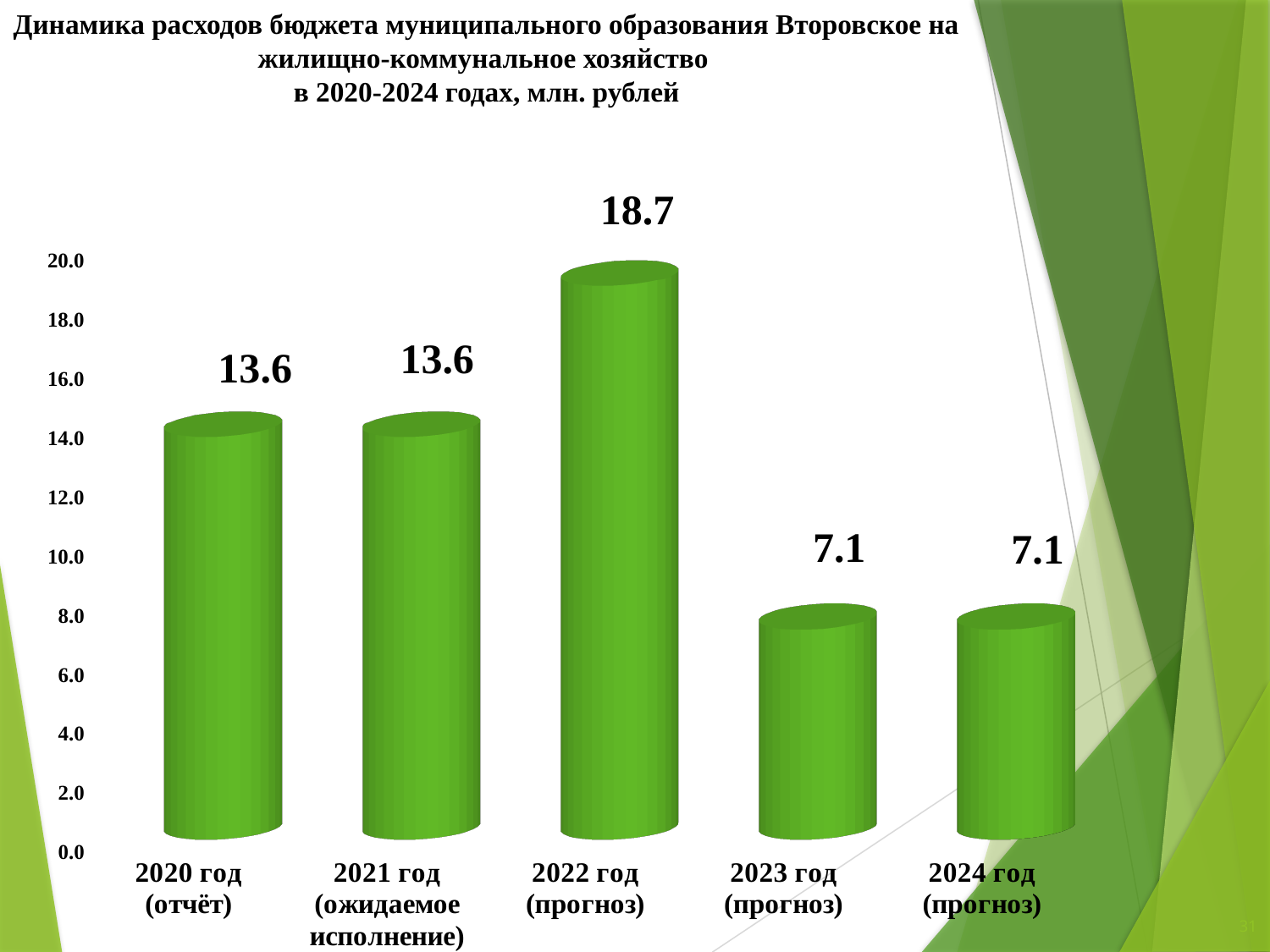
Is the value for 2023 год greater or less than 10.0? less What is the difference between the values for 2022 год and 2023 год? 11.6 Is the value for 2022 год greater or less than 16.0? greater Which year has the highest value? 2022 год (прогноз) What is the value for 2024 год (прогноз)? 7.1 Which is larger, the value for 2021 год or the value for 2023 год? 2021 год How many years are shown on the chart? 5 In what units are the values on the chart expressed, according to the title? млн. рублей What is the value for 2022 год (прогноз)? 18.7 What is the value for 2020 год (отчёт)? 13.6 What kind of chart is shown on the slide? bar chart What is the difference between the values for 2021 год and 2024 год? 6.5